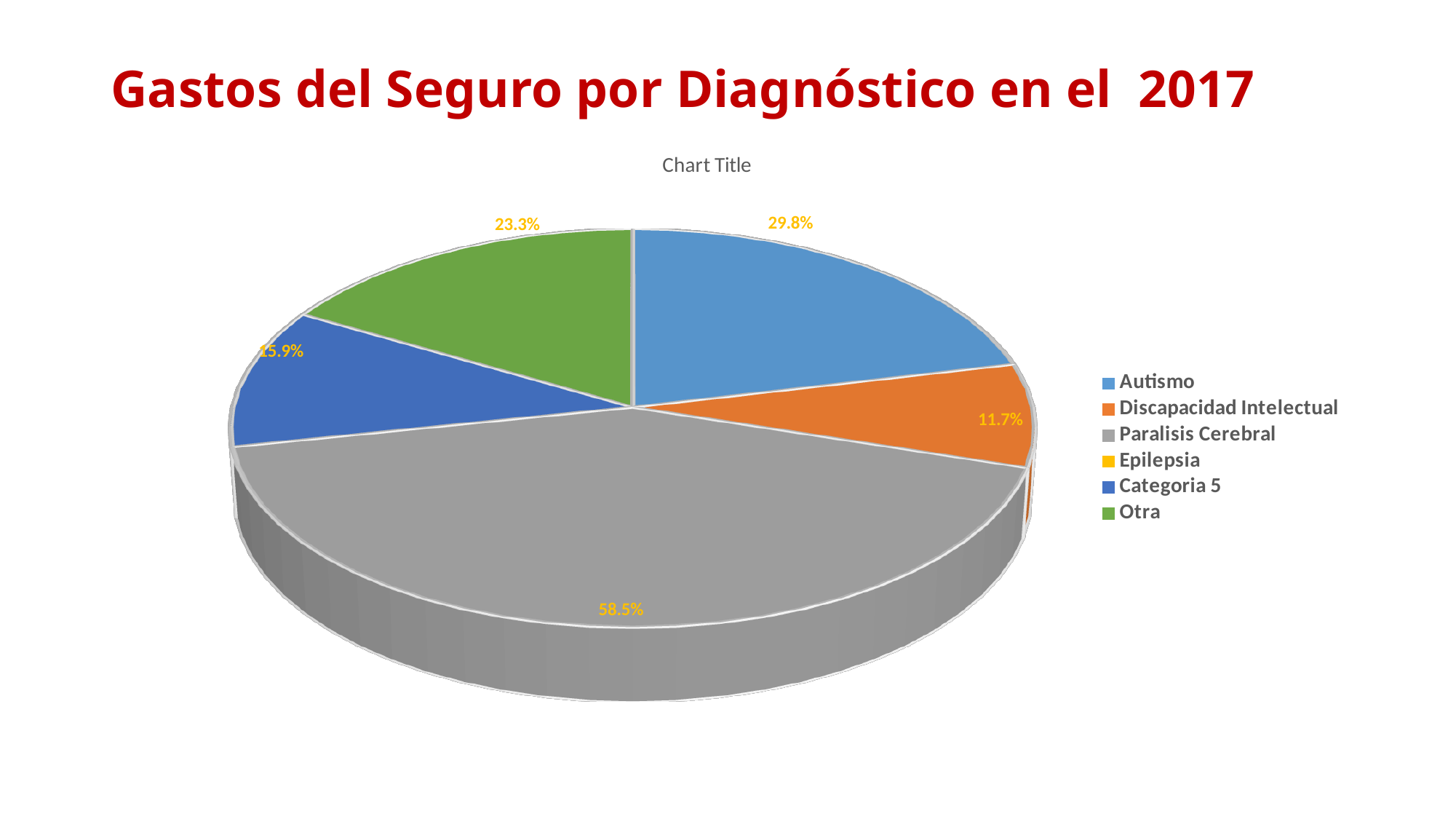
What type of chart is shown on the slide? Pie chart Which category has the largest slice of the pie? Paralisis Cerebral What is the difference in percentage points between Autismo and Discapacidad Intelectual? 18.1 Which is larger, the slice for Autismo or the slice for Otra? Autismo What percentage is shown for Otra? 23.3% What percentage is shown for Discapacidad Intelectual? 11.7% What colour represents Paralisis Cerebral in the chart? Gray What percentage is shown for Autismo? 29.8% What percentage is shown for Categoria 5? 15.9% How many categories does the legend list? 6 What percentage is shown for Paralisis Cerebral? 58.5%